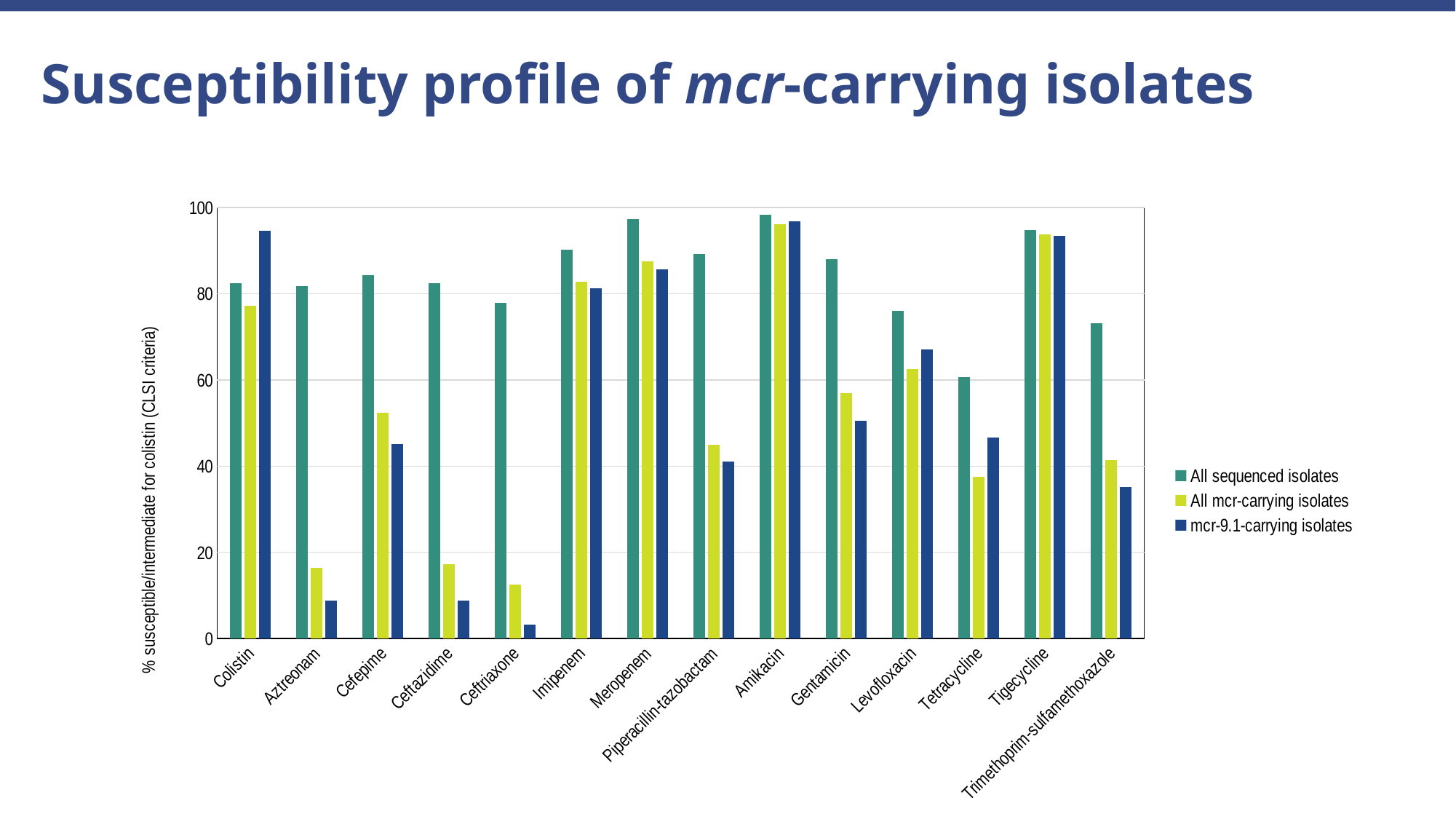
How many antibiotics (categories) are shown on the x axis? 14 Which antibiotic has the lowest value for All mcr-carrying isolates? Ceftriaxone What kind of chart is shown on the slide? Bar chart Which antibiotic has the lowest value for mcr-9.1-carrying isolates? Ceftriaxone Is the value for All sequenced isolates for Trimethoprim-sulfamethoxazole greater or less than 60? greater How many series does the legend list? 3 Is the value for All mcr-carrying isolates for Aztreonam greater or less than 20? less For Tetracycline, which is larger: All mcr-carrying isolates or mcr-9.1-carrying isolates? mcr-9.1-carrying isolates Is the value for All mcr-carrying isolates for Tetracycline greater or less than 40? less For Cefepime, which is larger: All sequenced isolates or All mcr-carrying isolates? All sequenced isolates What is the label on the y axis of the chart? % susceptible/intermediate for colistin (CLSI criteria)